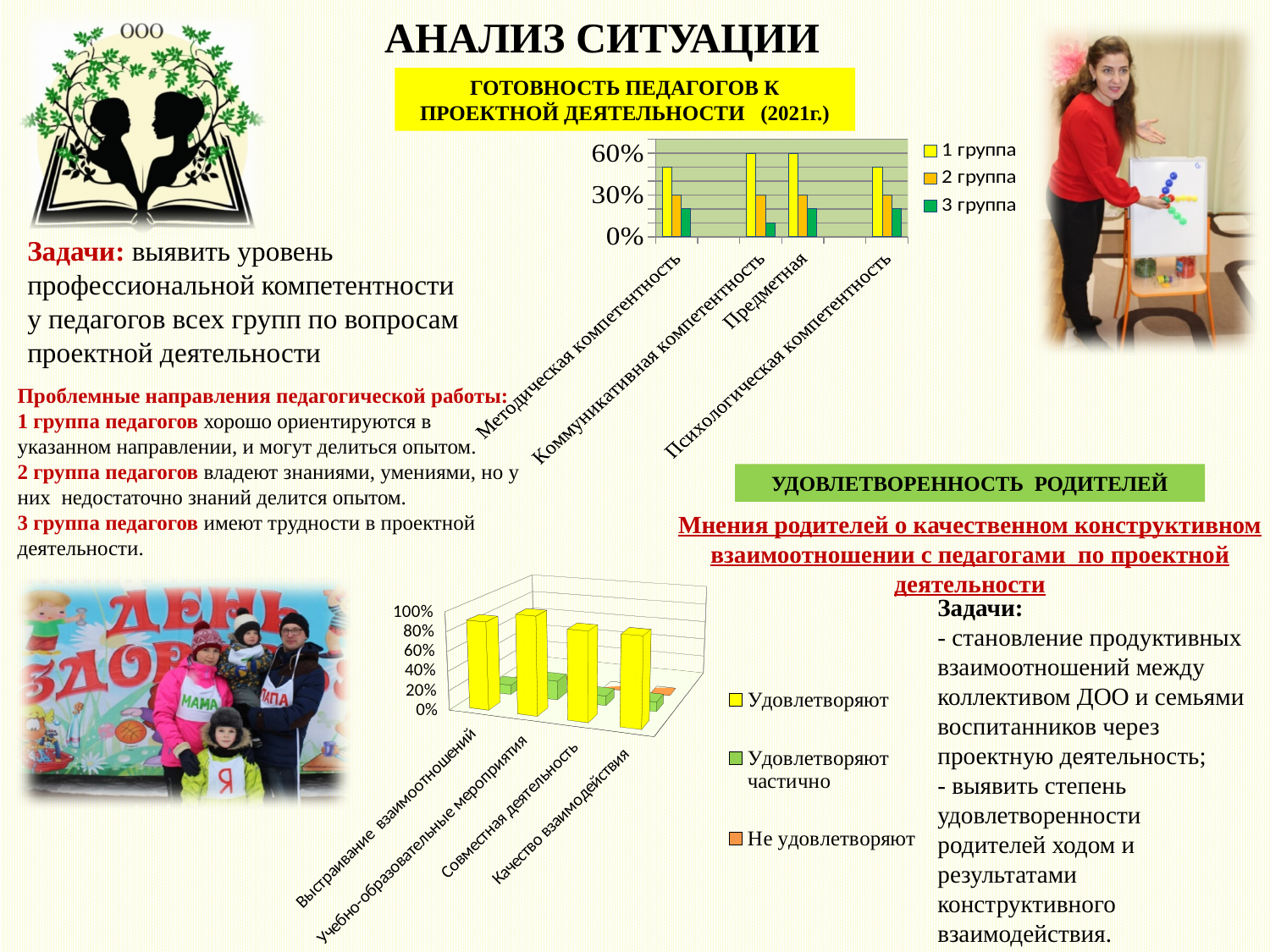
In the chart titled 'ГОТОВНОСТЬ ПЕДАГОГОВ К ПРОЕКТНОЙ ДЕЯТЕЛЬНОСТИ (2021г.)', which is larger in 'Предметная': the value for '2 группа' or for '3 группа'? 2 группа In the chart titled 'ГОТОВНОСТЬ ПЕДАГОГОВ К ПРОЕКТНОЙ ДЕЯТЕЛЬНОСТИ (2021г.)', how many series does the legend list? 3 In the bottom chart about parents' satisfaction, which series has the tallest bar in every category? Удовлетворяют In the chart titled 'ГОТОВНОСТЬ ПЕДАГОГОВ К ПРОЕКТНОЙ ДЕЯТЕЛЬНОСТИ (2021г.)', is the value for '1 группа' in 'Методическая компетентность' greater or less than 30%? greater In the chart titled 'ГОТОВНОСТЬ ПЕДАГОГОВ К ПРОЕКТНОЙ ДЕЯТЕЛЬНОСТИ (2021г.)', is the value for '3 группа' in 'Коммуникативная компетентность' greater or less than 30%? less In the chart titled 'ГОТОВНОСТЬ ПЕДАГОГОВ К ПРОЕКТНОЙ ДЕЯТЕЛЬНОСТИ (2021г.)', which colour represents '3 группа' in the legend? green In the chart titled 'ГОТОВНОСТЬ ПЕДАГОГОВ К ПРОЕКТНОЙ ДЕЯТЕЛЬНОСТИ (2021г.)', which series has the tallest bar in every category? 1 группа In the bottom chart about parents' satisfaction (Удовлетворяют / Удовлетворяют частично / Не удовлетворяют), how many series does the legend list? 3 What kind of chart is the one titled 'ГОТОВНОСТЬ ПЕДАГОГОВ К ПРОЕКТНОЙ ДЕЯТЕЛЬНОСТИ (2021г.)'? bar chart In the bottom chart about parents' satisfaction, how many categories are shown on the x axis? 4 In the chart titled 'ГОТОВНОСТЬ ПЕДАГОГОВ К ПРОЕКТНОЙ ДЕЯТЕЛЬНОСТИ (2021г.)', how many categories are shown on the x axis? 4 In the bottom chart about parents' satisfaction, is the value for 'Удовлетворяют' in 'Выстраивание взаимоотношений' greater or less than 60%? greater